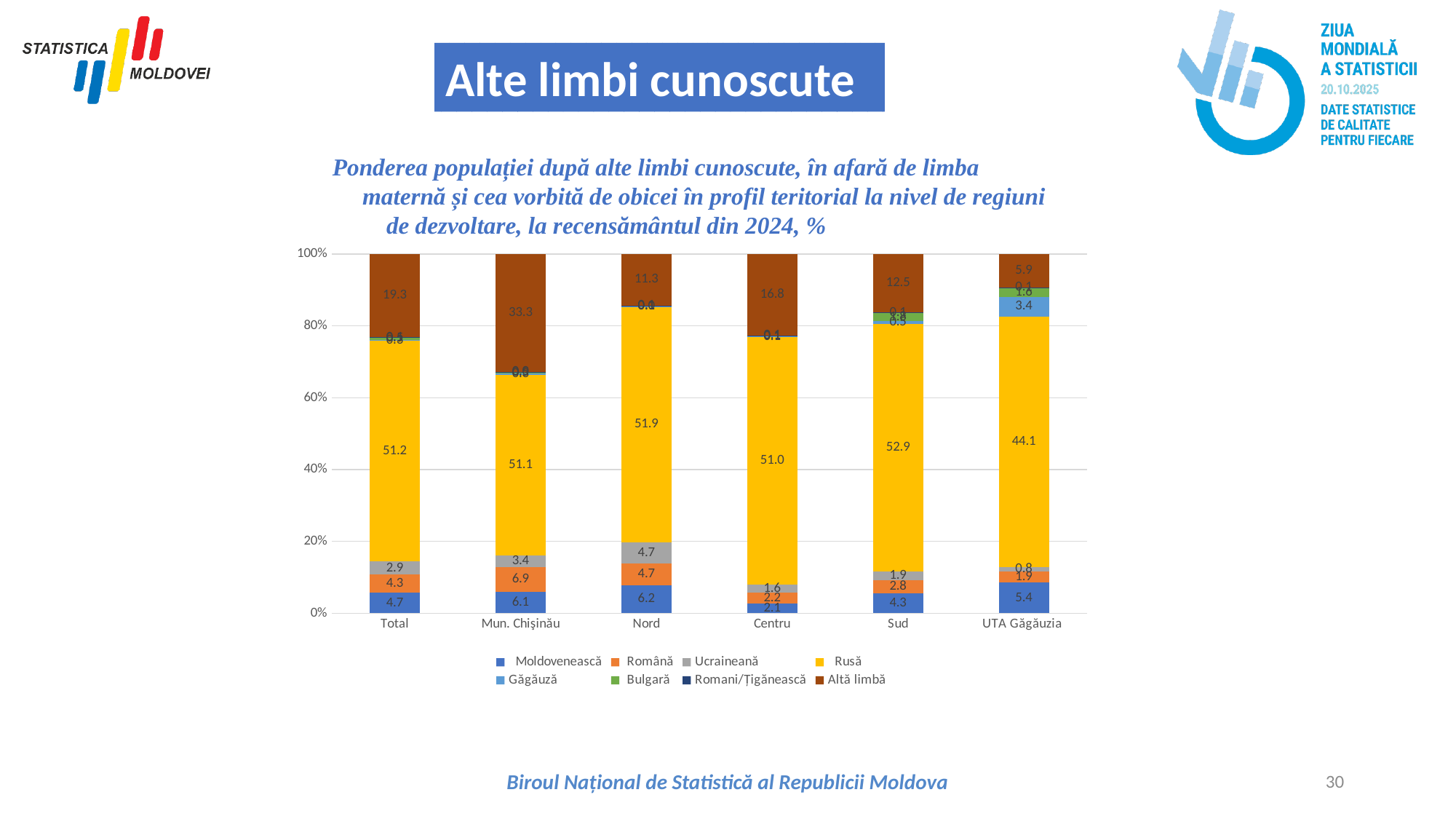
What is the difference between the Altă limbă values for Total and Nord? 8.0 What is the value for Rusă in the Sud bar? 52.9 What is the value for Ucraineană in the Nord bar? 4.7 How many regions (bars) are shown on the x axis? 6 Which has the larger Română value, Mun. Chișinău or Nord? Mun. Chișinău What is the value for Altă limbă in the Mun. Chișinău bar? 33.3 How many series does the legend list? 8 Which region has the highest value for Altă limbă? Mun. Chișinău What is the value for Moldovenească in the Centru bar? 2.1 Which region has the lowest value for Rusă? UTA Găgăuzia What is the value for Găgăuză in the UTA Găgăuzia bar? 3.4 What kind of chart is shown on the slide? Stacked bar chart